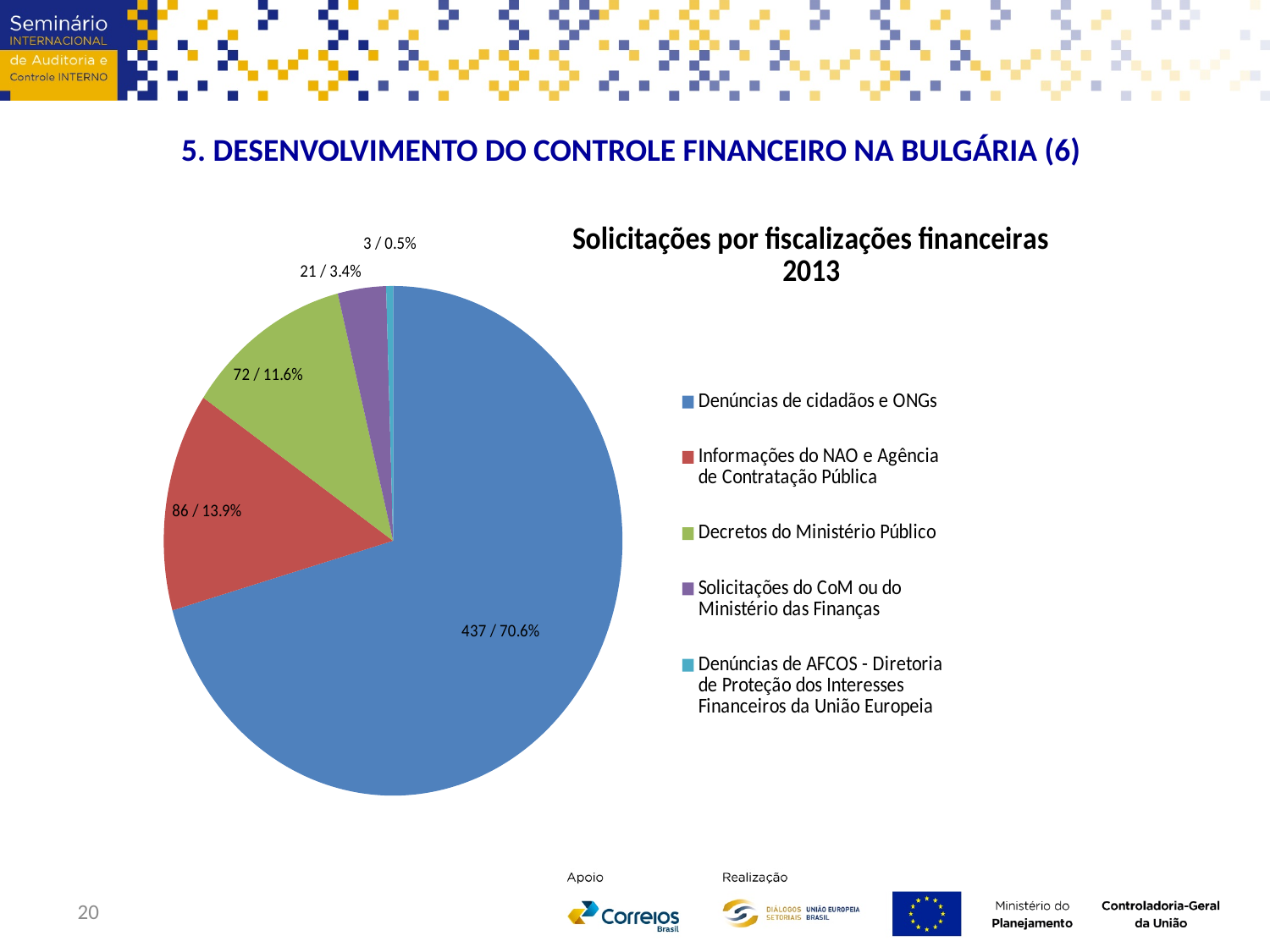
How many categories does the legend list? 5 What is the title of the chart? Solicitações por fiscalizações financeiras 2013 Which category has the largest slice of the pie? Denúncias de cidadãos e ONGs What is the value shown for Solicitações do CoM ou do Ministério das Finanças? 21 / 3.4% What is the value shown for Denúncias de cidadãos e ONGs? 437 / 70.6% What is the value shown for Informações do NAO e Agência de Contratação Pública? 86 / 13.9% What share of the pie does Denúncias de AFCOS - Diretoria de Proteção dos Interesses Financeiros da União Europeia represent? 0.5% Which is larger: the count for Decretos do Ministério Público or for Solicitações do CoM ou do Ministério das Finanças? Decretos do Ministério Público What is the value shown for Decretos do Ministério Público? 72 / 11.6% What is the difference in count between Informações do NAO e Agência de Contratação Pública and Decretos do Ministério Público? 14 What kind of chart is shown on the slide? Pie chart Which category has the smallest slice of the pie? Denúncias de AFCOS - Diretoria de Proteção dos Interesses Financeiros da União Europeia